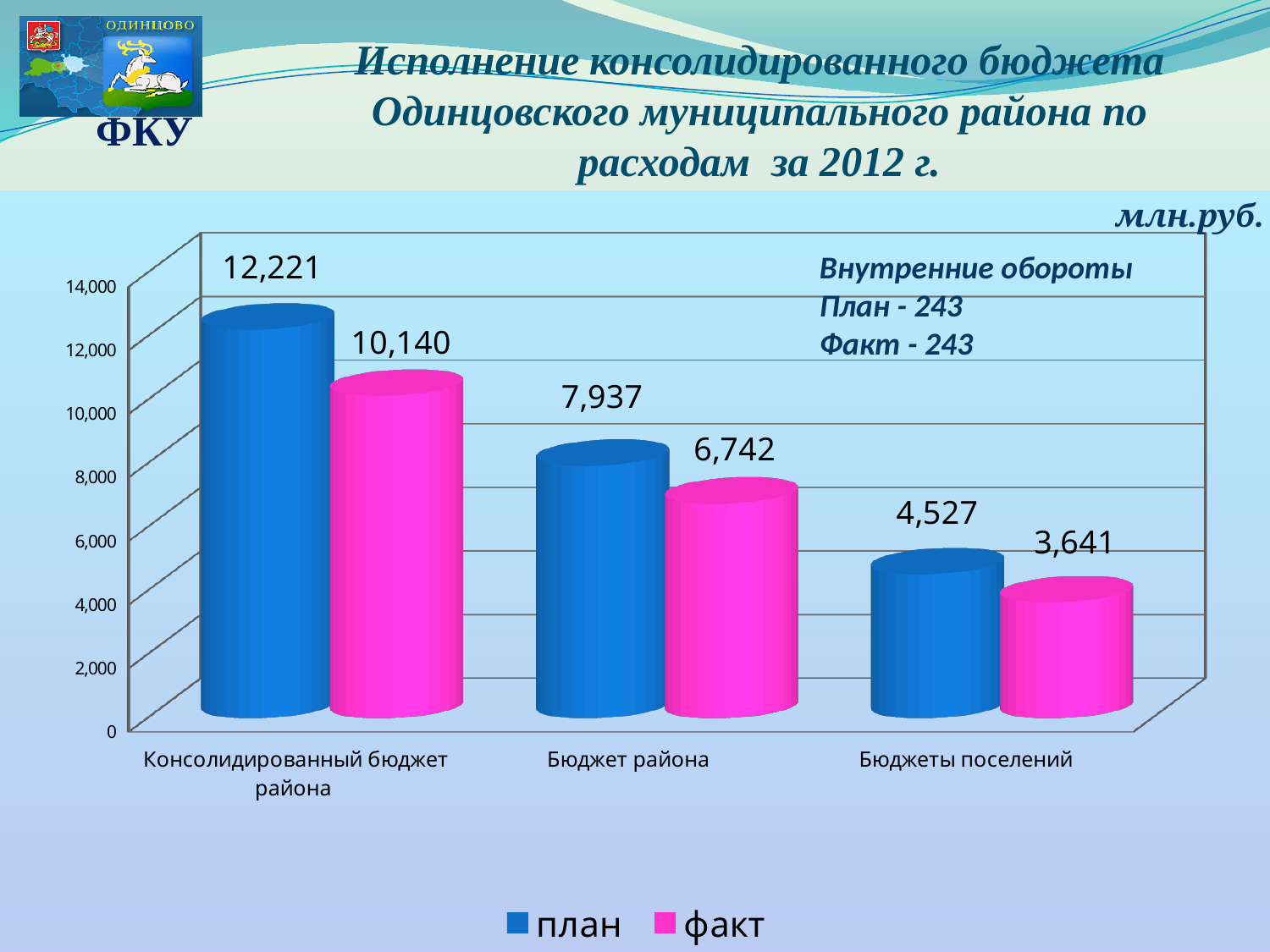
What unit is stated for the chart values? млн.руб. What is the факт value for Бюджет района? 6,742 How many categories are shown on the x axis? 3 How many series does the legend list? 2 What is the difference between план and факт for Бюджеты поселений? 886 What is the факт value for Бюджеты поселений? 3,641 Which category has the lowest факт value? Бюджеты поселений Which is larger for Бюджет района, план or факт? план What is the план value for Консолидированный бюджет района? 12,221 Which category has the highest план value? Консолидированный бюджет района What kind of chart is shown on the slide? bar chart What is the difference between план and факт for Консолидированный бюджет района? 2,081